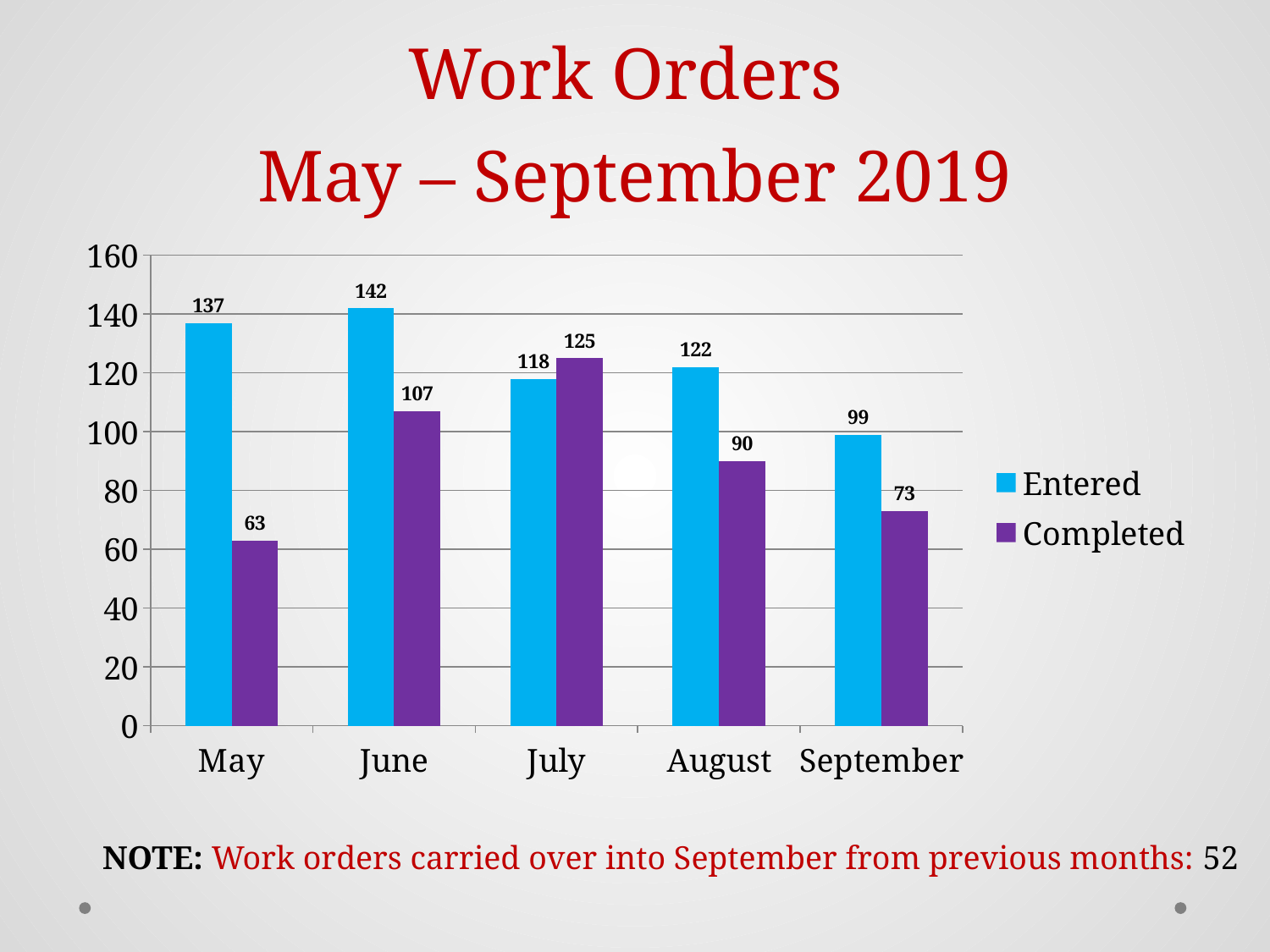
How many work orders were completed in August? 90 Which month has the lowest number of work orders completed? May How many months are shown on the x axis? 5 What is the difference between work orders entered and completed in May? 74 Is the value for work orders entered in September greater or less than 100? less How many work orders were completed in May? 63 Which month has the highest number of work orders entered? June Which colour represents the Completed series? Purple How many work orders were entered in June? 142 How many series does the legend list? 2 In July, were more work orders entered or completed? Completed What kind of chart is shown on the slide? Bar chart